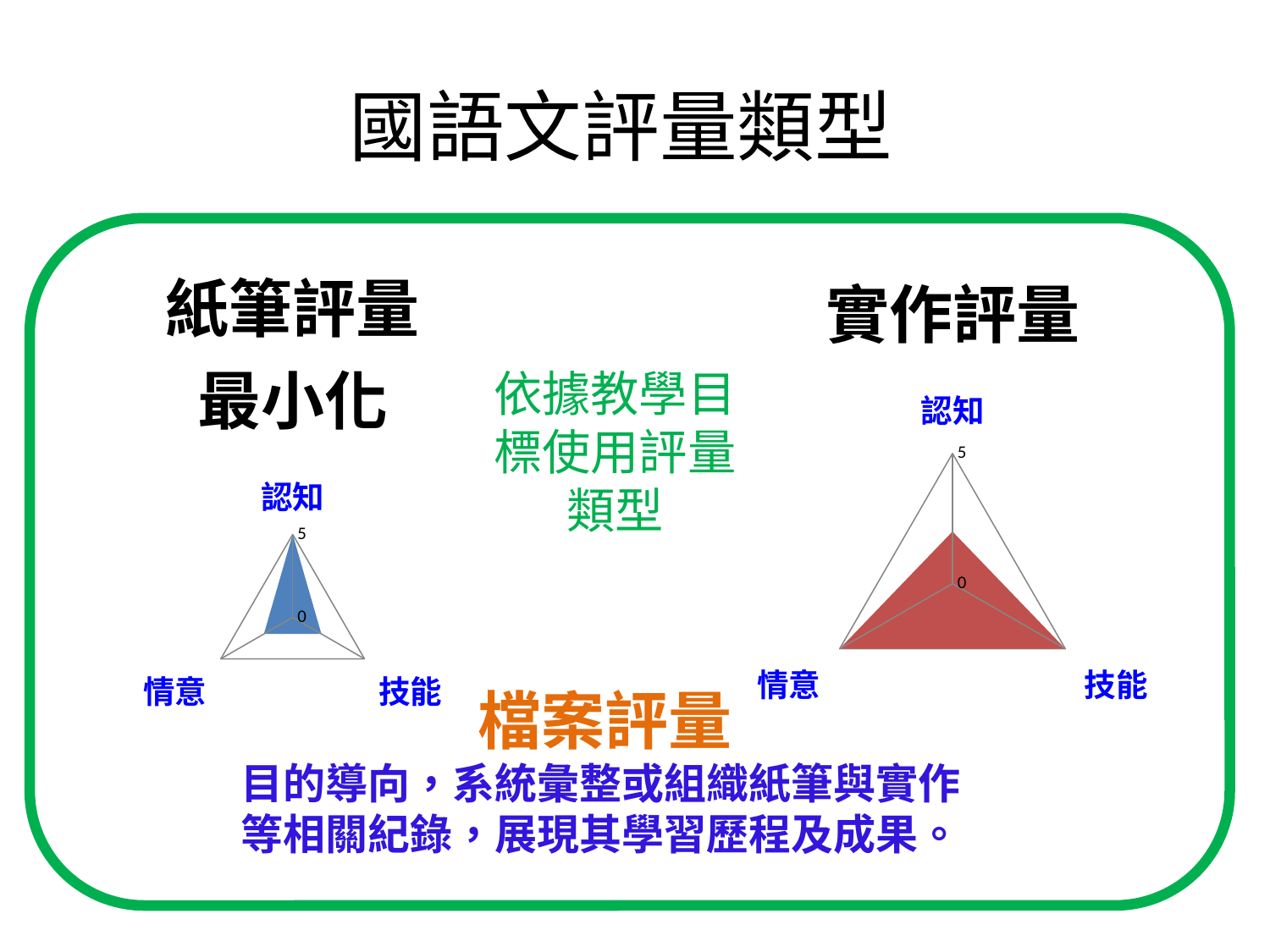
How many axes (categories) does the radar chart on the right under 實作評量 have? 3 In the left radar chart (紙筆評量), which category has the highest value? 認知 In the left radar chart (紙筆評量), is the value for 情意 greater or less than 5? less In the left radar chart (紙筆評量), what value does 認知 reach? 5 What is the maximum value shown on the axis scale of the left radar chart (紙筆評量)? 5 In the right radar chart (實作評量), what value does 技能 reach? 5 In the left radar chart (紙筆評量), which is larger, the value for 認知 or the value for 技能? 認知 In the right radar chart (實作評量), which category has the lowest value? 認知 In the right radar chart (實作評量), which is larger, the value for 情意 or the value for 認知? 情意 In the right radar chart (實作評量), is the value for 認知 greater or less than 5? less What kind of chart is shown under the heading 紙筆評量 on the left of the slide? radar chart What colour is the filled area in the right radar chart (實作評量)? red